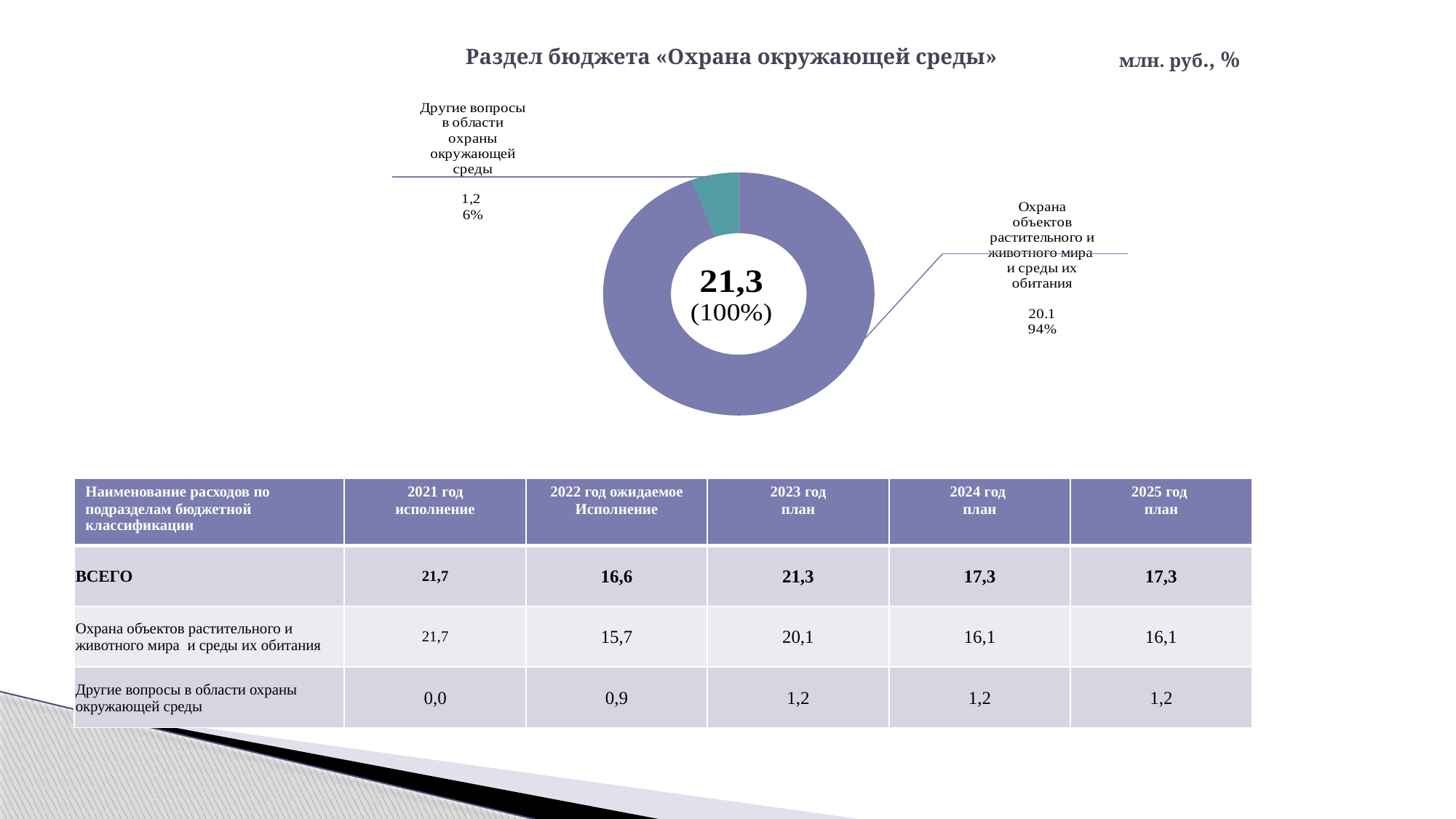
What value is shown for the slice «Охрана объектов растительного и животного мира и среды их обитания»? 20.1 Which slice of the pie chart is the largest? Охрана объектов растительного и животного мира и среды их обитания What kind of chart is shown on the slide? Pie (donut) chart What share of the pie does «Другие вопросы в области охраны окружающей среды» take? 6% Which slice of the pie chart is the smallest? Другие вопросы в области охраны окружающей среды How many slices does the pie chart have? 2 What is the title of the chart on the slide? Раздел бюджета «Охрана окружающей среды» What units are indicated for the chart values? млн. руб., % Which is larger: the slice for «Охрана объектов растительного и животного мира» or the slice for «Другие вопросы в области охраны окружающей среды»? Охрана объектов растительного и животного мира What total value is shown in the centre of the donut chart? 21,3 (100%) What share of the pie does «Охрана объектов растительного и животного мира и среды их обитания» take? 94% What value is shown for the slice «Другие вопросы в области охраны окружающей среды»? 1,2